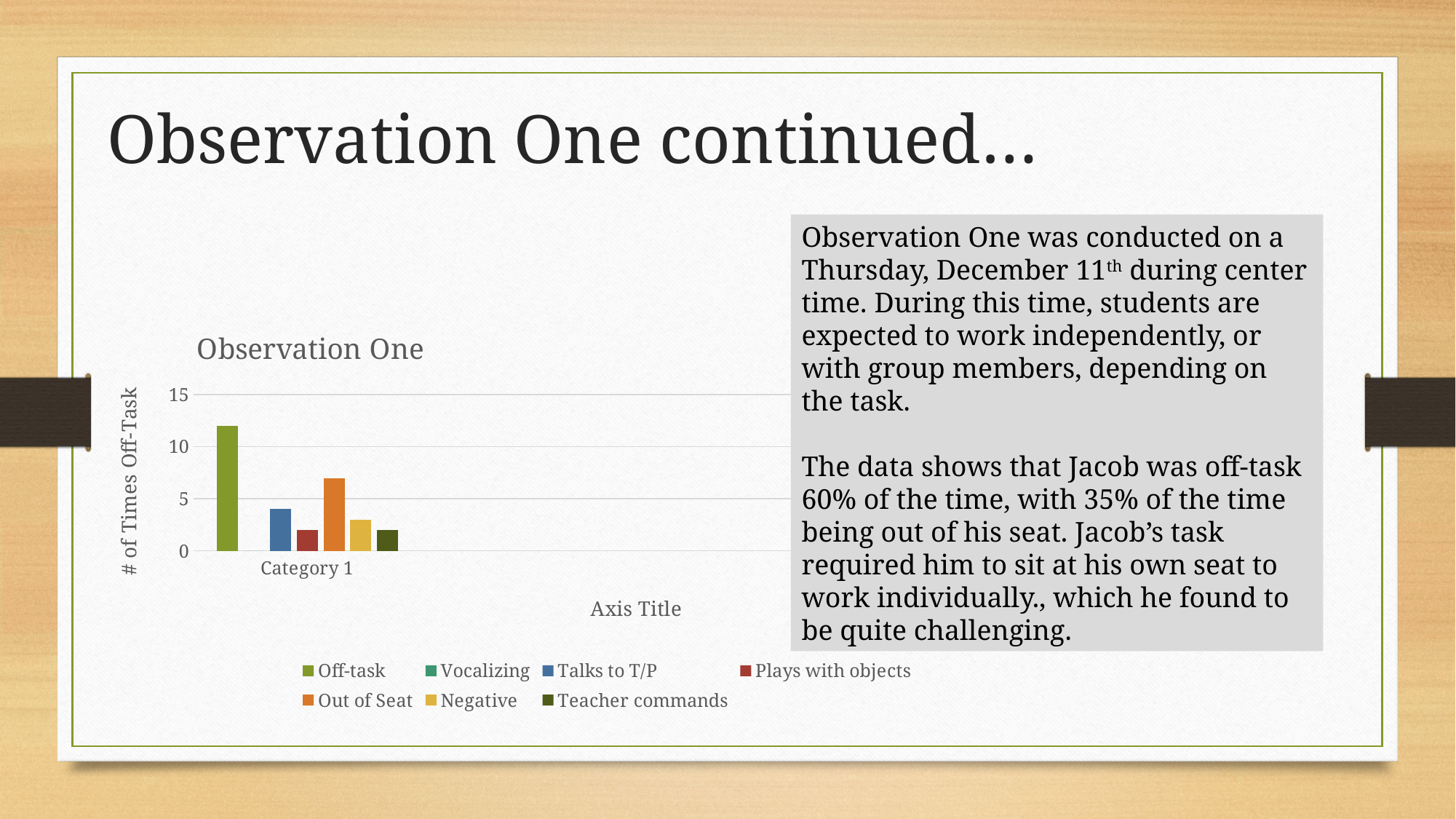
How many categories are shown on the x axis of the chart? 1 Is the value for Negative greater or less than 5? less Which is larger, the value for Out of Seat or the value for Talks to T/P? Out of Seat What kind of chart is shown on the slide? bar chart What is the title of the chart? Observation One How many series does the legend of the chart list? 7 What is the label on the vertical axis of the chart? # of Times Off-Task Is the value for Out of Seat greater or less than 5? greater Which is larger, the value for Off-task or the value for Out of Seat? Off-task Which series has the tallest bar in the chart? Off-task Is the value for Talks to T/P greater or less than 5? less